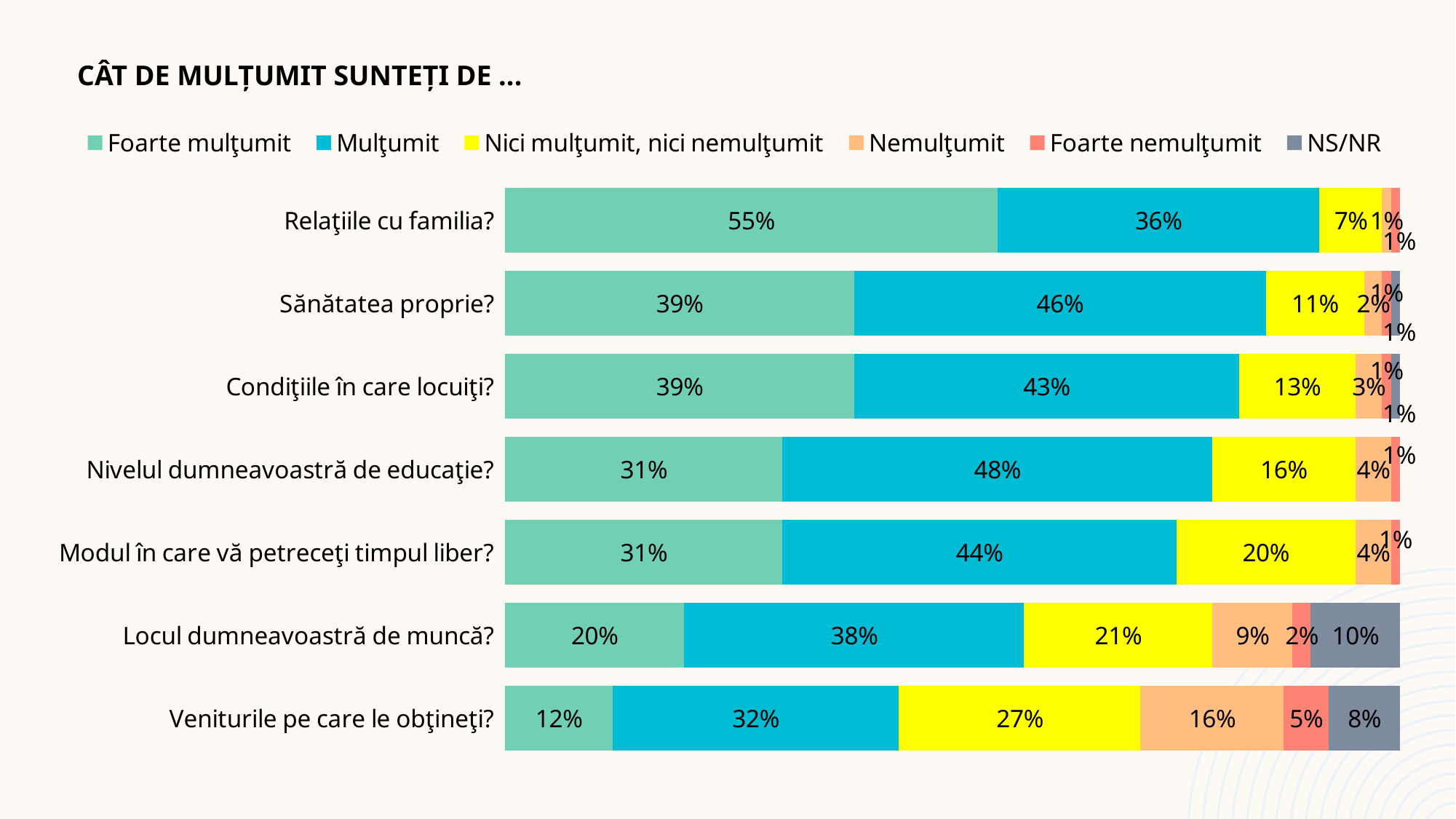
What is the total of the stacked bar for "Veniturile pe care le obţineţi?" 100% Which has a larger "Mulţumit" share: "Sănătatea proprie?" or "Condiţiile în care locuiţi?" Sănătatea proprie? What percentage of respondents are "Foarte mulţumit" with "Relaţiile cu familia?" 55% What is the "NS/NR" value for "Locul dumneavoastră de muncă?" 10% What is the "Nemulţumit" value for "Veniturile pe care le obţineţi?" 16% What type of chart is shown on the slide? Stacked bar chart What is the difference between the "Nici mulţumit, nici nemulţumit" values for "Veniturile pe care le obţineţi?" and "Relaţiile cu familia?" 20% Which category has the highest "Foarte mulţumit" share? Relaţiile cu familia? How many series does the legend list? 6 Which category has the lowest "Foarte mulţumit" share? Veniturile pe care le obţineţi? What is the "Mulţumit" value for "Nivelul dumneavoastră de educaţie?" 48% How many categories (questions) are shown in the chart? 7